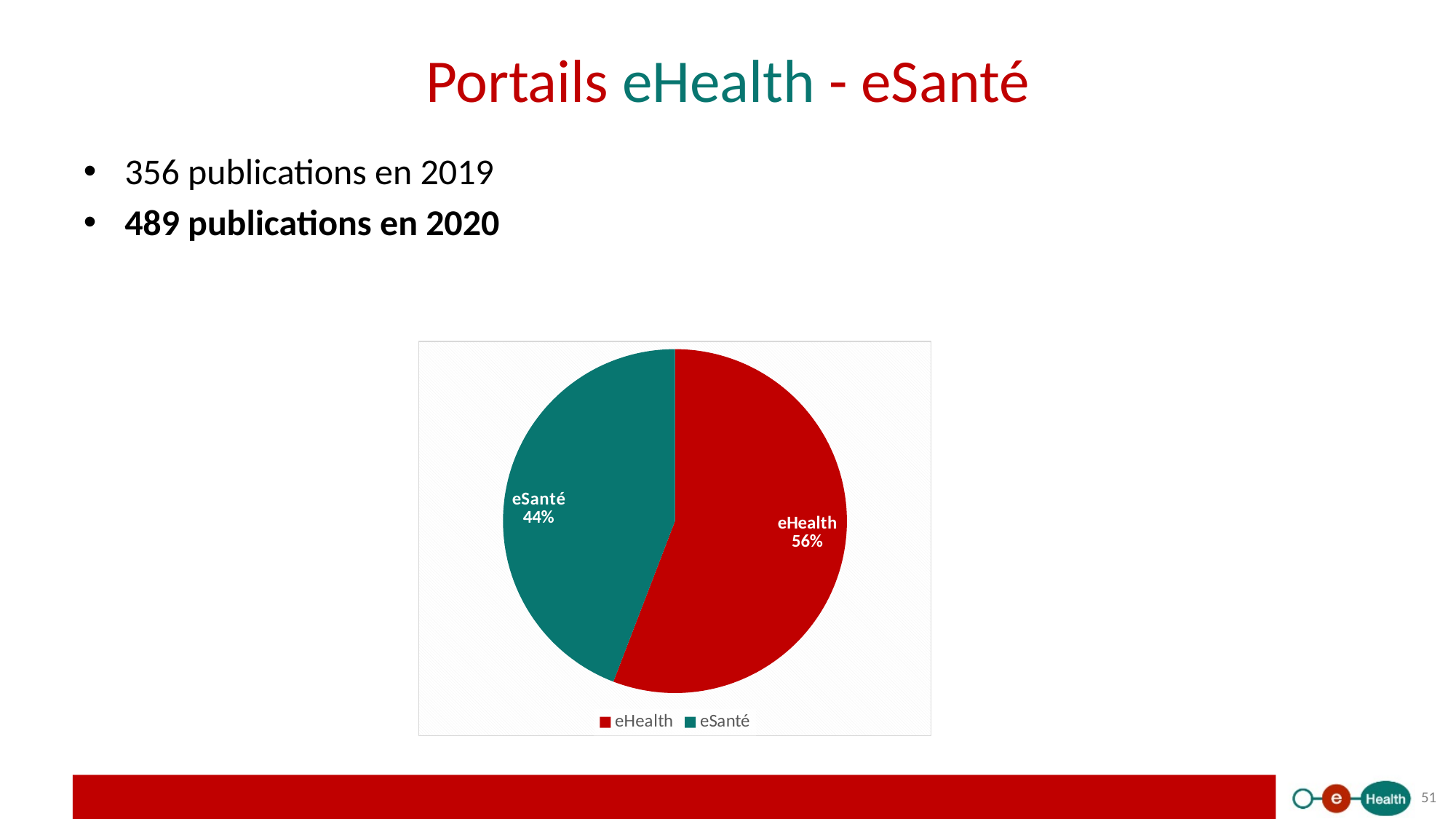
How many entries does the legend list? 2 How many slices does the pie chart have? 2 What colour is the eSanté slice? teal Which slice of the pie is the largest? eHealth What kind of chart is shown on the slide? pie chart Which is larger, the eHealth slice or the eSanté slice? eHealth What share of the pie does eHealth have? 56% What is the difference in percentage points between the eHealth and eSanté slices? 12 What colour is the eHealth slice? red Which slice of the pie is the smallest? eSanté What share of the pie does eSanté have? 44%